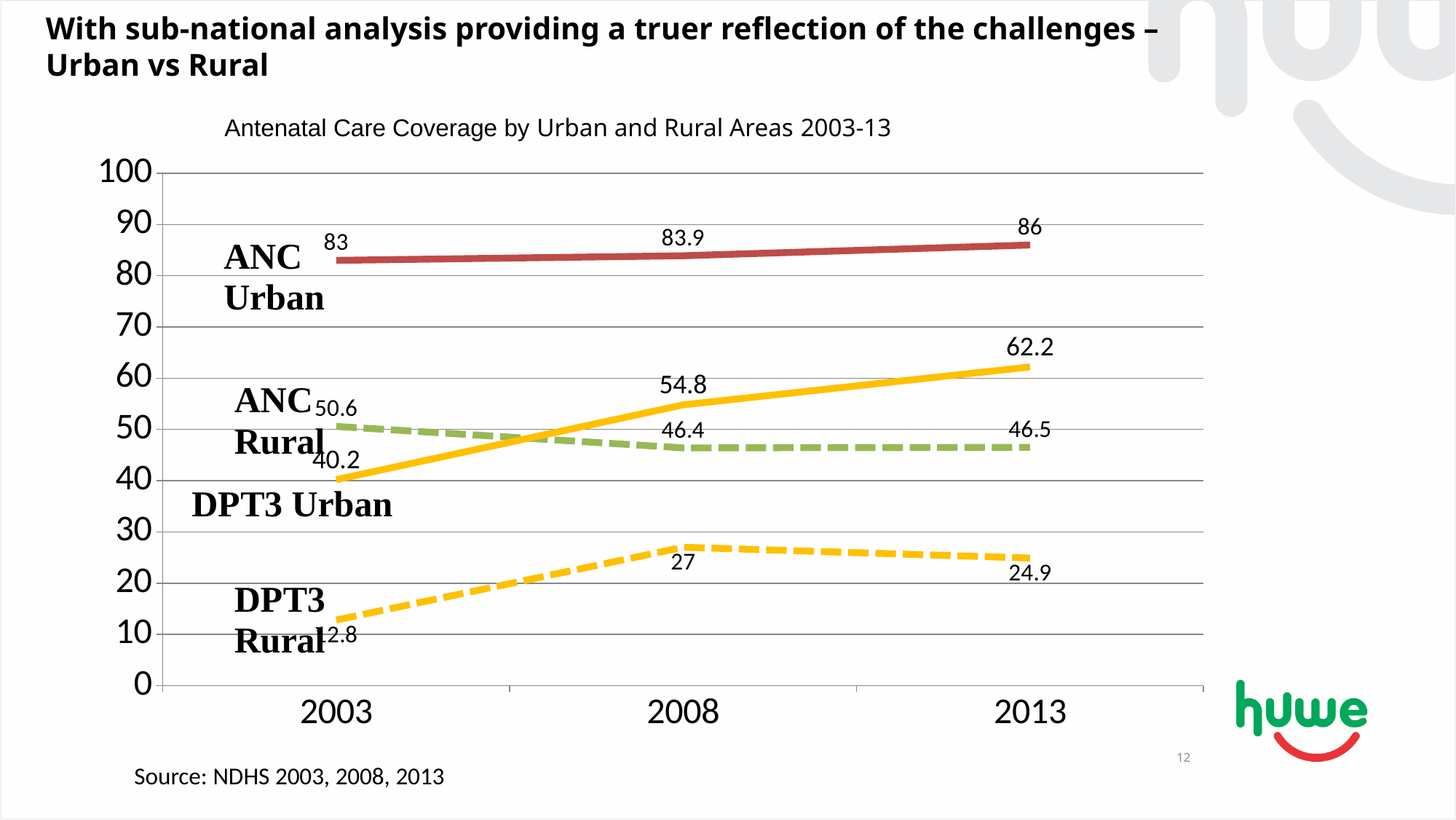
What is the ANC Urban value in 2013? 86 What is the DPT3 Urban value in 2008? 54.8 What is the ANC Rural value in 2003? 50.6 By how much did the DPT3 Urban value increase from 2003 to 2013? 22 Which series has the highest value in 2013? ANC Urban By how much did the ANC Urban value increase from 2003 to 2013? 3 How many years are shown on the x axis? 3 In 2003, which is larger: ANC Rural or DPT3 Urban? ANC Rural What kind of chart is shown on the slide? line chart Does the DPT3 Urban line rise or fall from 2003 to 2013? rise What is the DPT3 Rural value in 2013? 24.9 Which series has the lowest value in 2008? DPT3 Rural